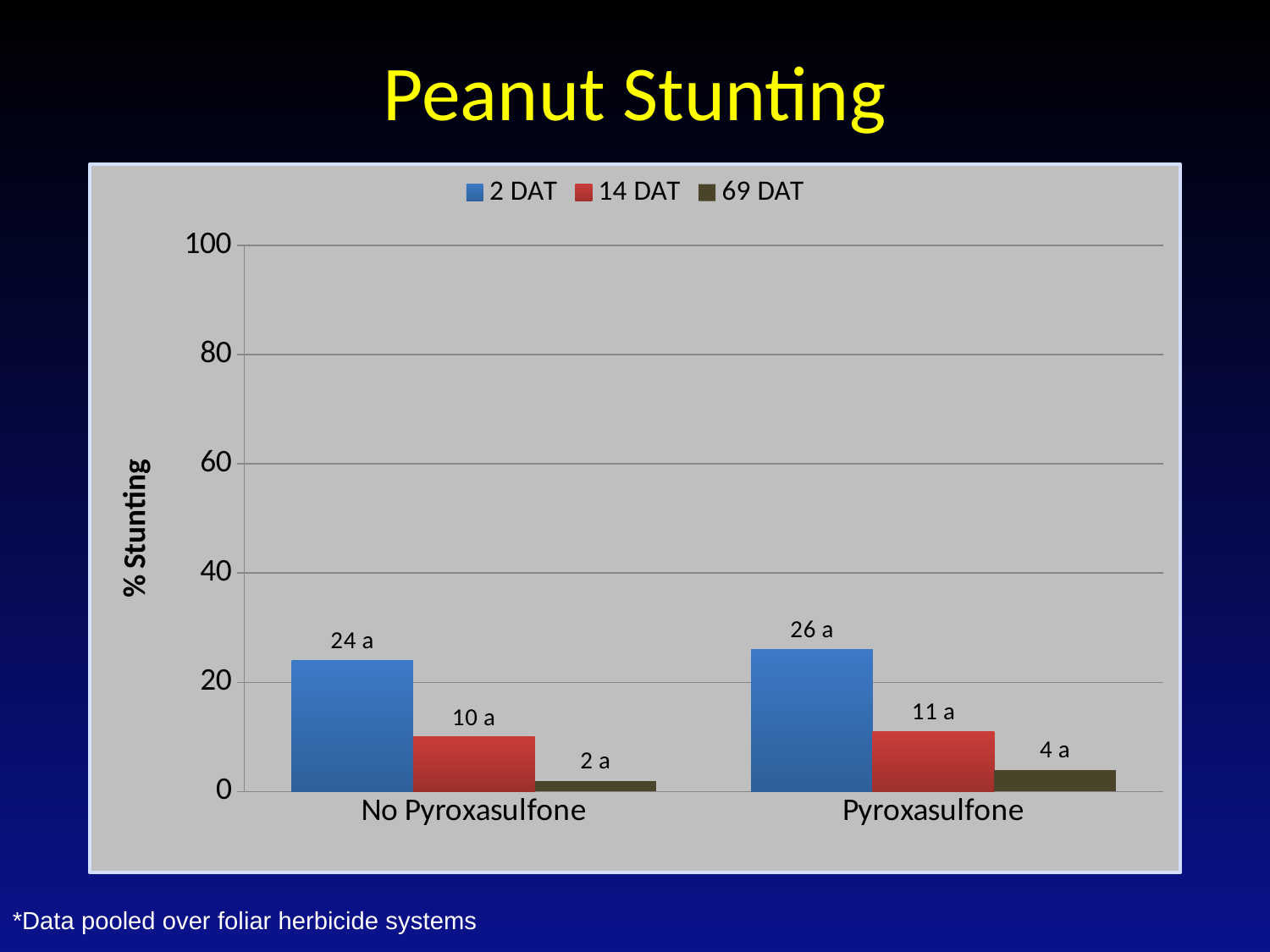
Which series has the highest value in the Pyroxasulfone category? 2 DAT What is the label of the y axis? % Stunting What is the value for 14 DAT in the Pyroxasulfone category? 11 a What kind of chart is shown on the slide? bar chart Which is larger: the 14 DAT value for No Pyroxasulfone or the 14 DAT value for Pyroxasulfone? Pyroxasulfone How many categories are shown on the x axis? 2 Is the 2 DAT value for Pyroxasulfone greater or less than 20? greater How many series does the legend list? 3 What is the value for 2 DAT in the No Pyroxasulfone category? 24 a Which series has the lowest value in the No Pyroxasulfone category? 69 DAT What is the value for 69 DAT in the Pyroxasulfone category? 4 a What is the difference between the 2 DAT values for Pyroxasulfone and No Pyroxasulfone? 2